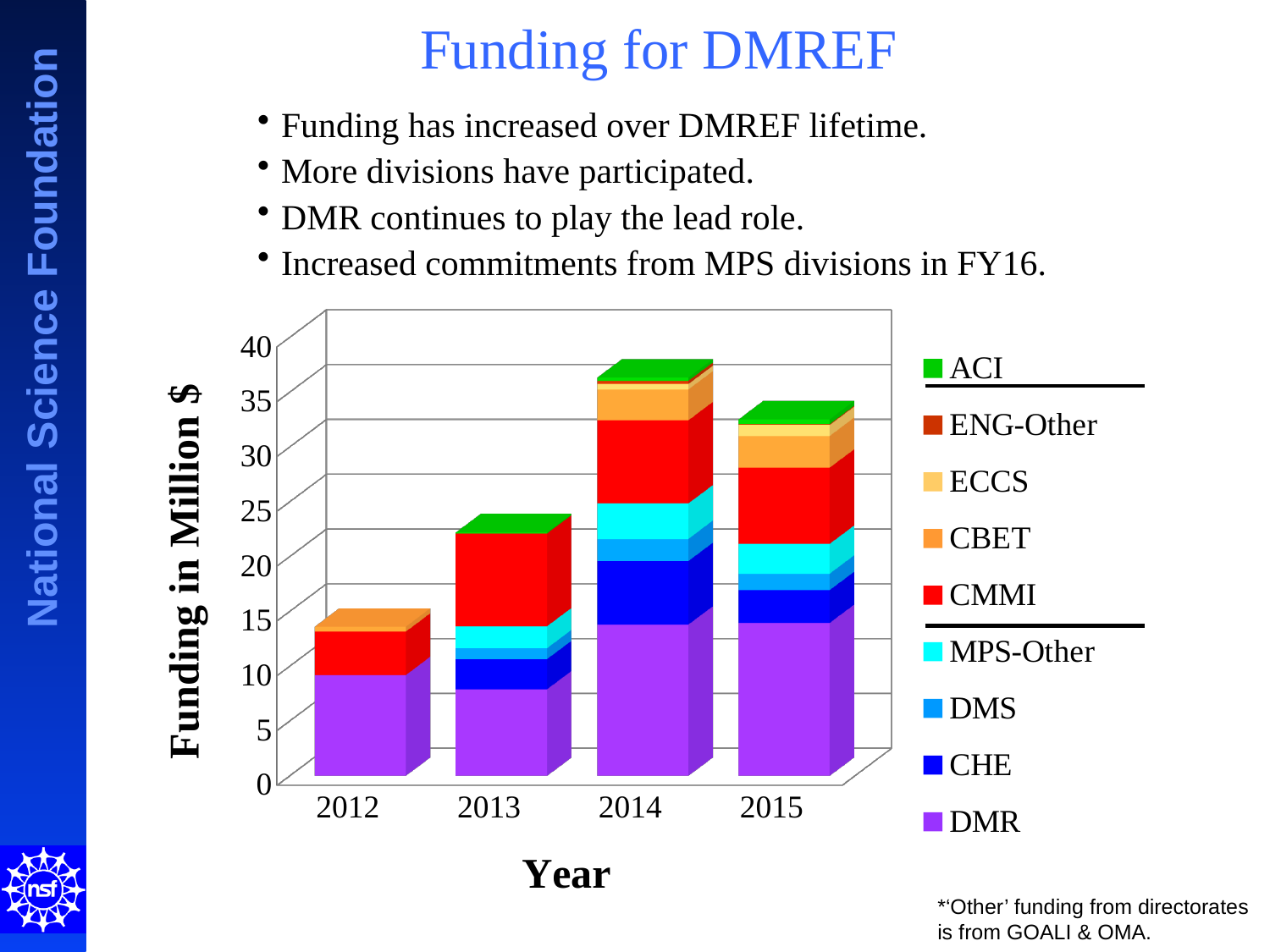
Does the total funding rise or fall from 2012 to 2014? rise Is the total funding for 2013 greater or less than 20? greater What is the title of the chart's vertical axis? Funding in Million $ Is the total funding for 2012 greater or less than 10? greater Which year has the lowest total funding bar? 2012 Which year has the larger total funding bar, 2014 or 2015? 2014 How many years are shown on the x axis of the chart? 4 Which year has the highest total funding bar? 2014 Is the total funding for 2014 greater or less than 30? greater How many series does the chart's legend list? 9 What kind of chart is shown on the slide? stacked bar chart